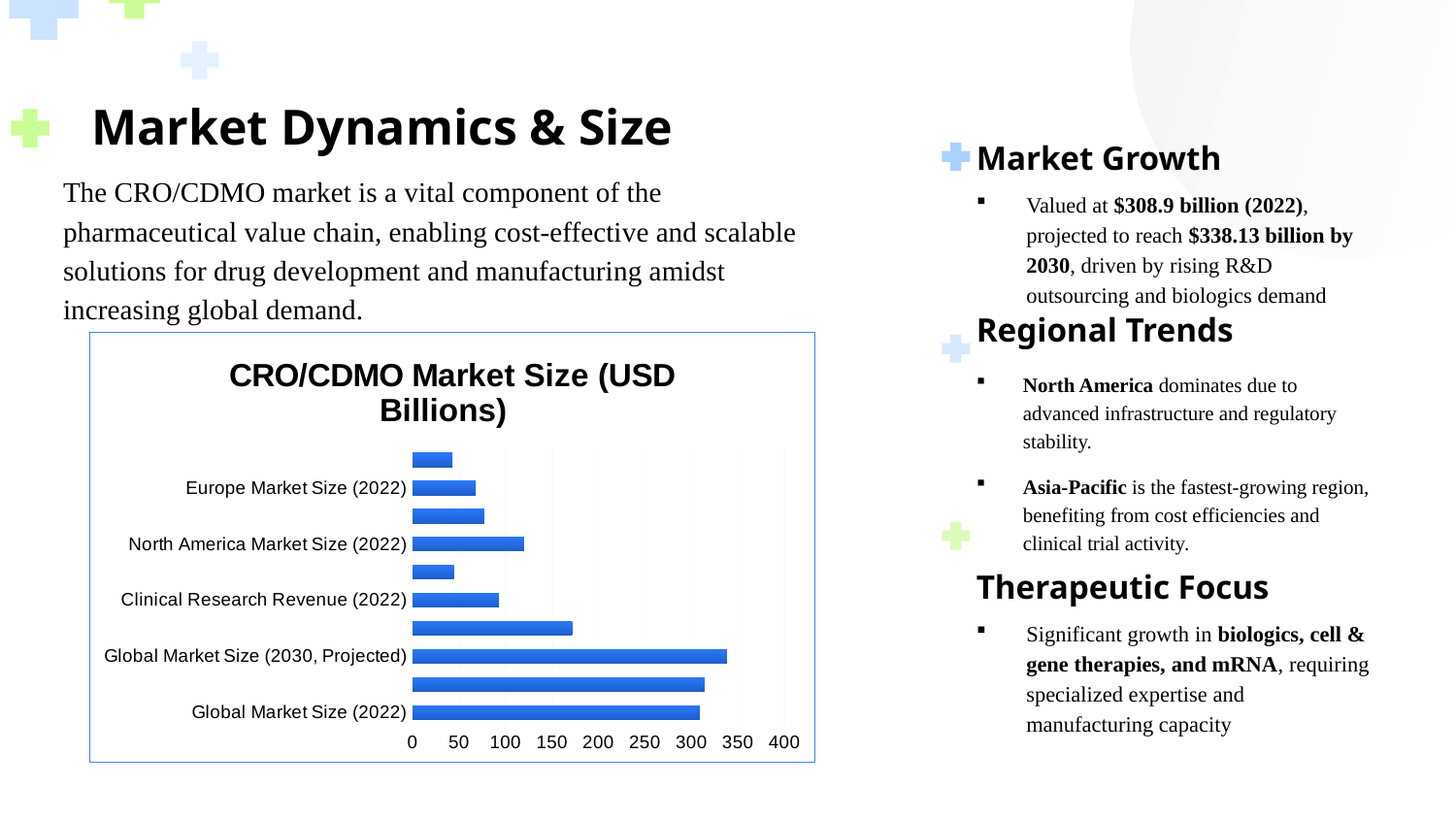
Which category has the longest bar in the chart? Global Market Size (2030, Projected) What kind of chart is shown on the slide? bar chart Is the value for Global Market Size (2030, Projected) greater or less than 300? greater Which is larger, Global Market Size (2030, Projected) or Global Market Size (2022)? Global Market Size (2030, Projected) How many bars are plotted in the chart? 10 What is the title of the chart? CRO/CDMO Market Size (USD Billions) Is the value for Clinical Research Revenue (2022) greater or less than 50? greater Is the value for North America Market Size (2022) greater or less than 150? less What is the highest value shown on the horizontal axis of the chart? 400 Which is larger, North America Market Size (2022) or Europe Market Size (2022)? North America Market Size (2022)